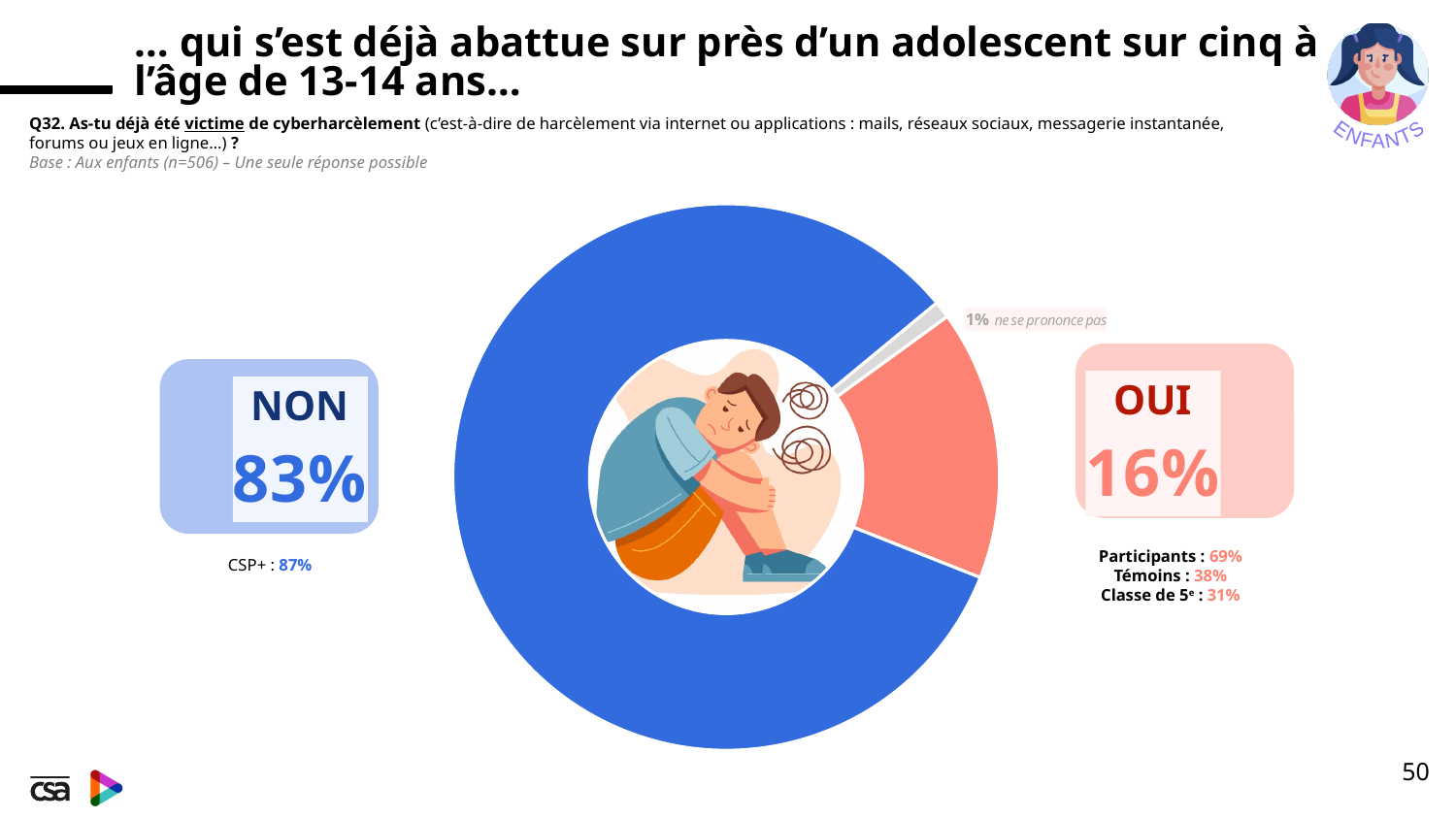
What colour is the OUI slice of the pie chart? Red (salmon) What colour is the NON slice of the pie chart? Blue Which response has the largest slice of the pie chart? NON What is the combined share of the OUI and 'ne se prononce pas' slices? 17% How many slices does the pie chart have? 3 What percentage of children answered NON (no) to having been a victim of cyberbullying? 83% What kind of chart is shown on the slide? Pie chart Which response has the smallest slice of the pie chart? ne se prononce pas What percentage of children answered OUI (yes) to having been a victim of cyberbullying? 16% What share of respondents is labelled 'ne se prononce pas'? 1% Which is larger, the OUI slice or the NON slice? NON What is the difference in percentage points between the NON and OUI slices? 67